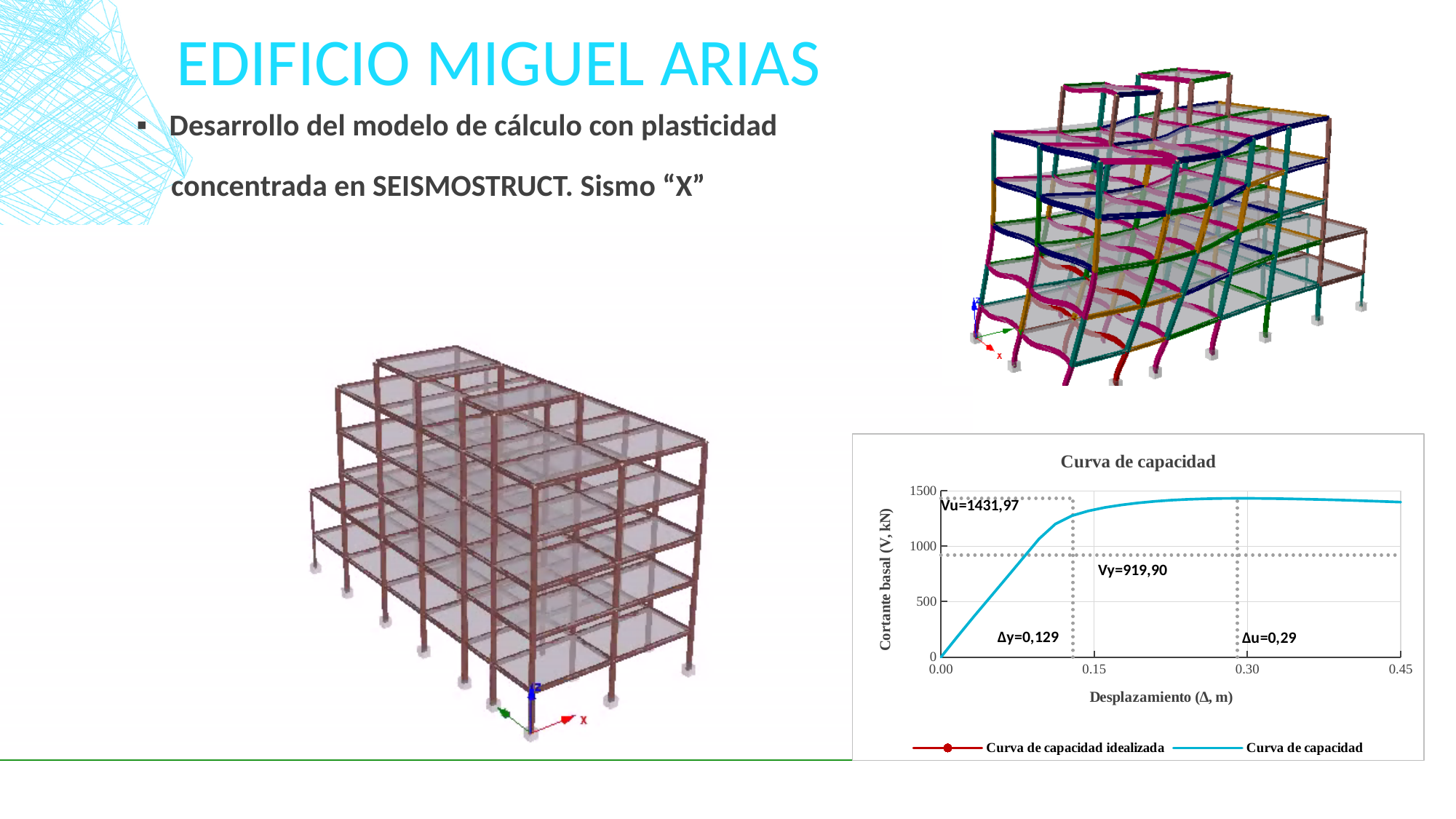
In the 'Curva de capacidad' chart, what is the value of Vu? 1431,97 How many series does the legend of the 'Curva de capacidad' chart list? 2 In the 'Curva de capacidad' chart, which is larger, Vu or Vy? Vu What is the title of the chart on the slide? Curva de capacidad In the 'Curva de capacidad' chart, what is the value of Δu? 0,29 In the 'Curva de capacidad' chart, what is the value of Δy? 0,129 What is the label of the vertical axis of the 'Curva de capacidad' chart? Cortante basal (V, kN) In the 'Curva de capacidad' chart, does the base shear rise or fall as displacement increases from 0.00 to 0.15 m? rise In the 'Curva de capacidad' chart, is the base shear at a displacement of 0.15 m greater or less than 1000? greater In the 'Curva de capacidad' chart, what is the value of Vy? 919,90 What kind of chart is the 'Curva de capacidad' chart? line chart In the 'Curva de capacidad' chart, what is the difference between Vu and Vy? 512,07